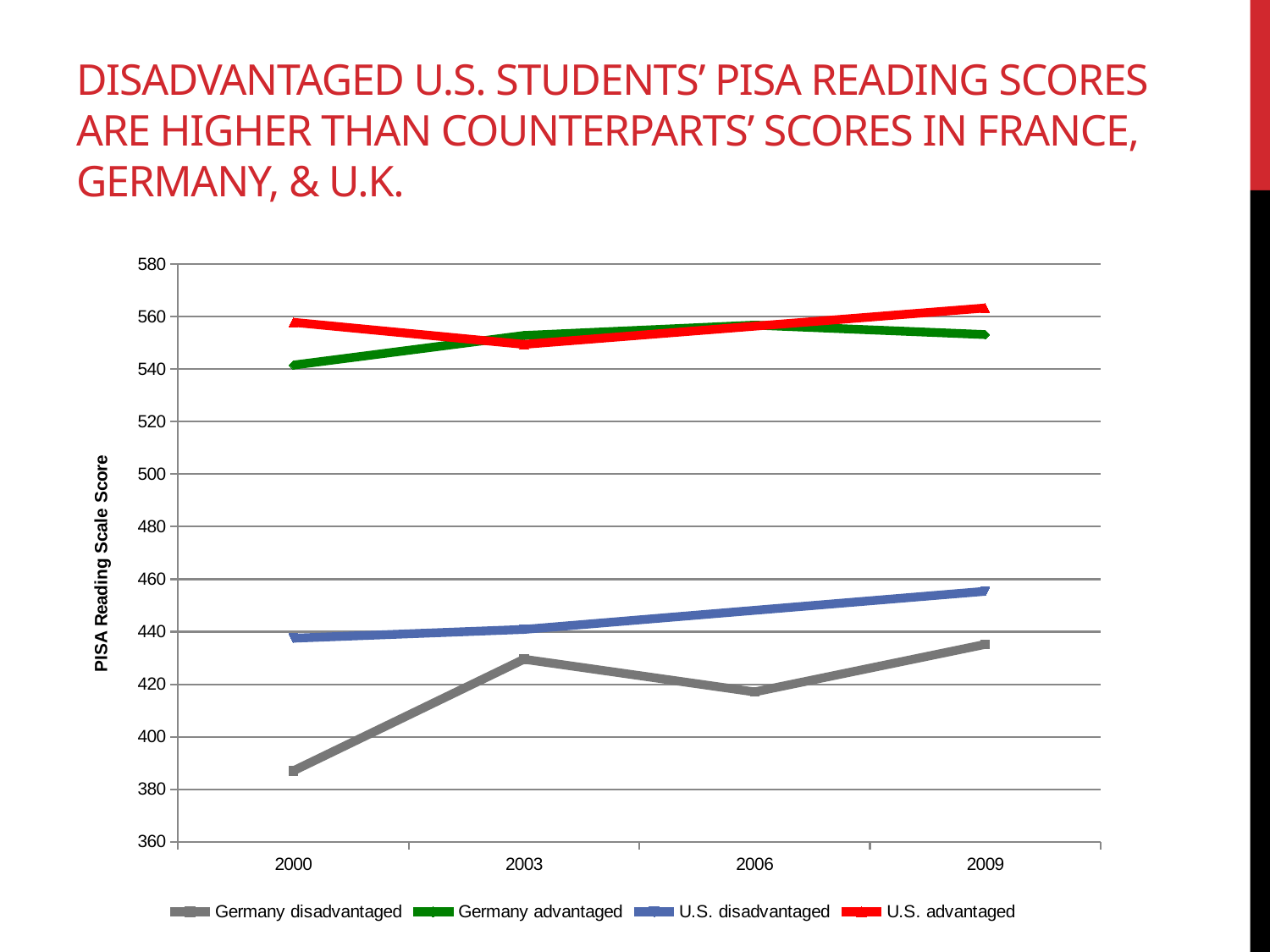
How many years are plotted along the x axis? 4 How many series does the legend list? 4 In 2000, which is higher: U.S. disadvantaged or Germany disadvantaged? U.S. disadvantaged In which year is the Germany disadvantaged score lowest? 2000 Is the value for Germany disadvantaged in 2000 greater or less than 400? less Which series has the highest value in 2009? U.S. advantaged For Germany disadvantaged, which is higher: the 2003 value or the 2006 value? 2003 Is the value for U.S. disadvantaged in 2009 greater or less than 440? greater Does the U.S. disadvantaged line rise or fall from 2000 to 2009? rise Is the value for Germany advantaged in 2000 greater or less than 520? greater What kind of chart is shown on the slide? line chart What is the title of the y axis? PISA Reading Scale Score